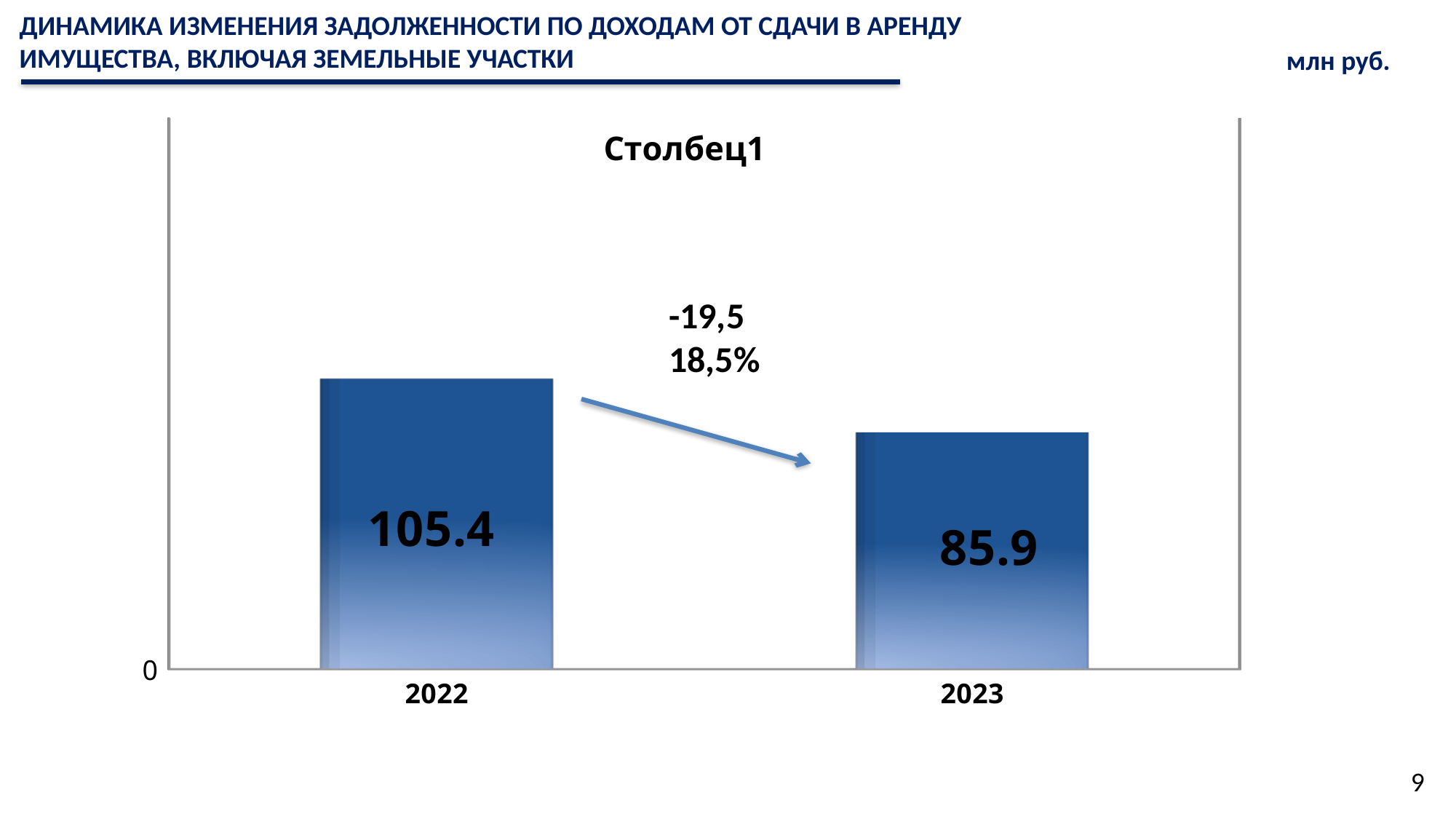
What is the difference between the values for 2022 and 2023? 19.5 What kind of chart is shown on the slide? bar chart Which year has the lowest value? 2023 Which is larger, the value for 2022 or the value for 2023? 2022 What is the value for 2023? 85.9 How many bars are shown in the chart? 2 What unit is indicated in the top right corner of the slide? млн руб. What percentage change is annotated between the two bars? 18,5% Which year has the highest value? 2022 What is the value for 2022? 105.4 What is the chart's title? Столбец1 Do the values rise or fall from 2022 to 2023? fall